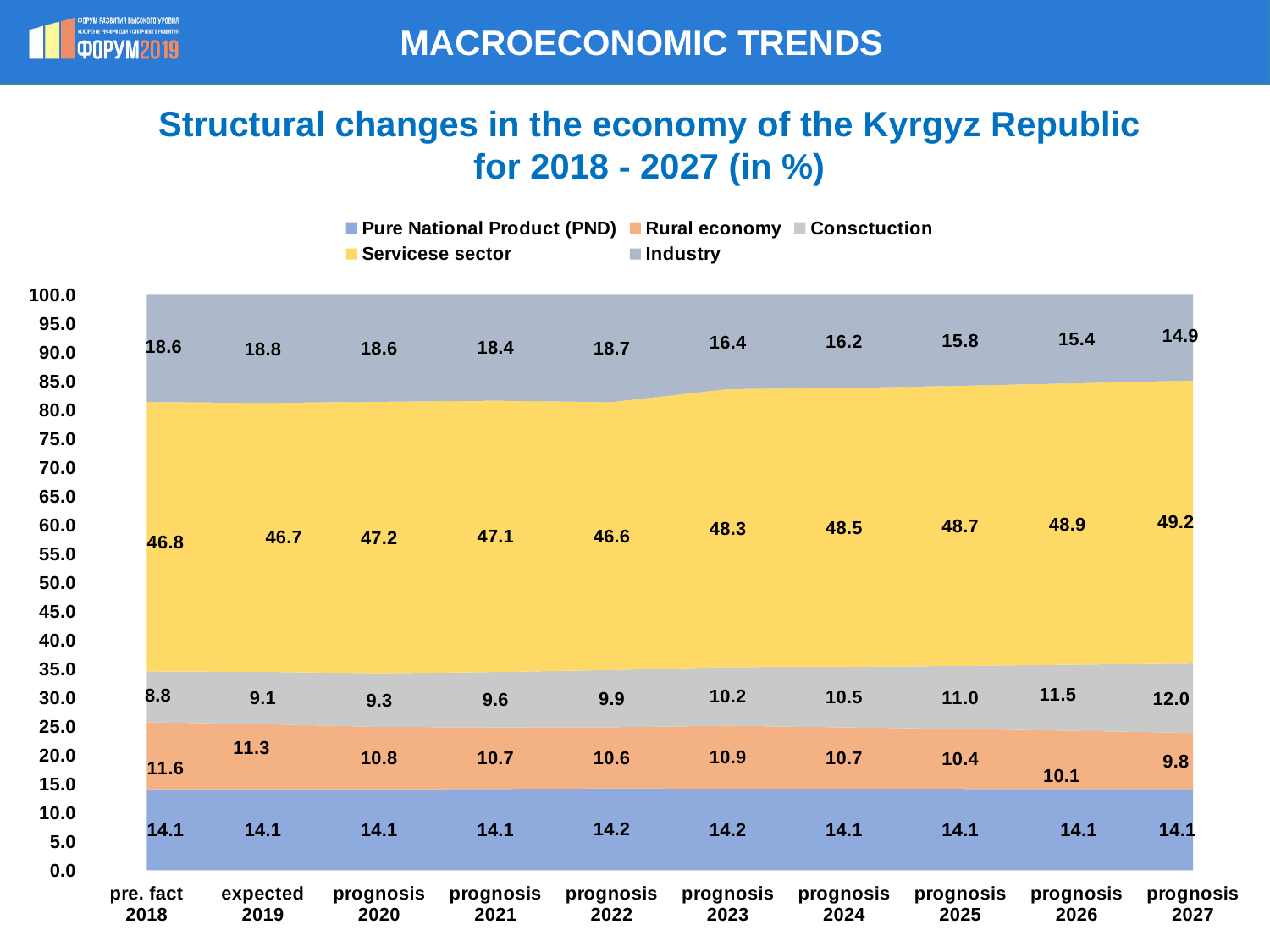
In which year is the Consctuction series highest? prognosis 2027 What is the difference between the Industry value for pre. fact 2018 and for prognosis 2027? 3.7 Does the Consctuction series rise or fall from 2018 to 2027? rises What is the value of the Rural economy series for expected 2019? 11.3 What is the value of the Servicese sector series for prognosis 2027? 49.2 What kind of chart is shown on the slide? stacked area chart How many series does the legend list? 5 How many years (categories) are shown on the x axis? 10 Which is larger, the Servicese sector value for prognosis 2022 or for prognosis 2023? prognosis 2023 In which year is the Rural economy series lowest? prognosis 2027 What is the value of the Industry series for pre. fact 2018? 18.6 What is the difference between the Consctuction value for prognosis 2027 and for pre. fact 2018? 3.2